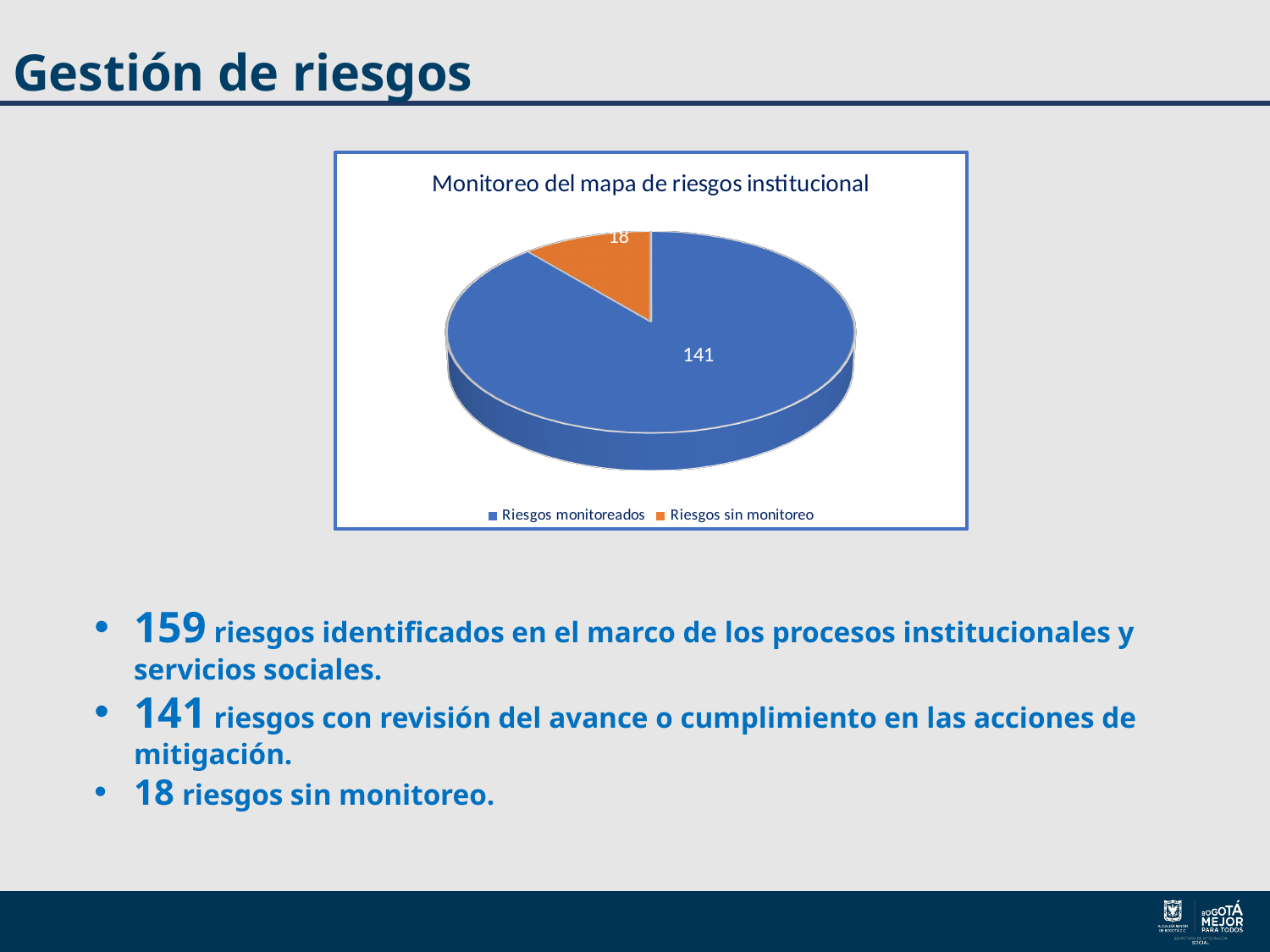
What is the value for Riesgos monitoreados? 141 What is the value for Riesgos sin monitoreo? 18 What is the total of all slices in the pie chart? 159 How many slices does the pie chart have? 2 What is the difference between Riesgos monitoreados and Riesgos sin monitoreo? 123 What colour is the slice for Riesgos sin monitoreo? Orange Which category has the smallest slice of the pie? Riesgos sin monitoreo What kind of chart is shown on the slide? Pie chart What is the title of the chart? Monitoreo del mapa de riesgos institucional How many entries does the legend list? 2 Which is larger, Riesgos monitoreados or Riesgos sin monitoreo? Riesgos monitoreados Which category has the largest slice of the pie? Riesgos monitoreados